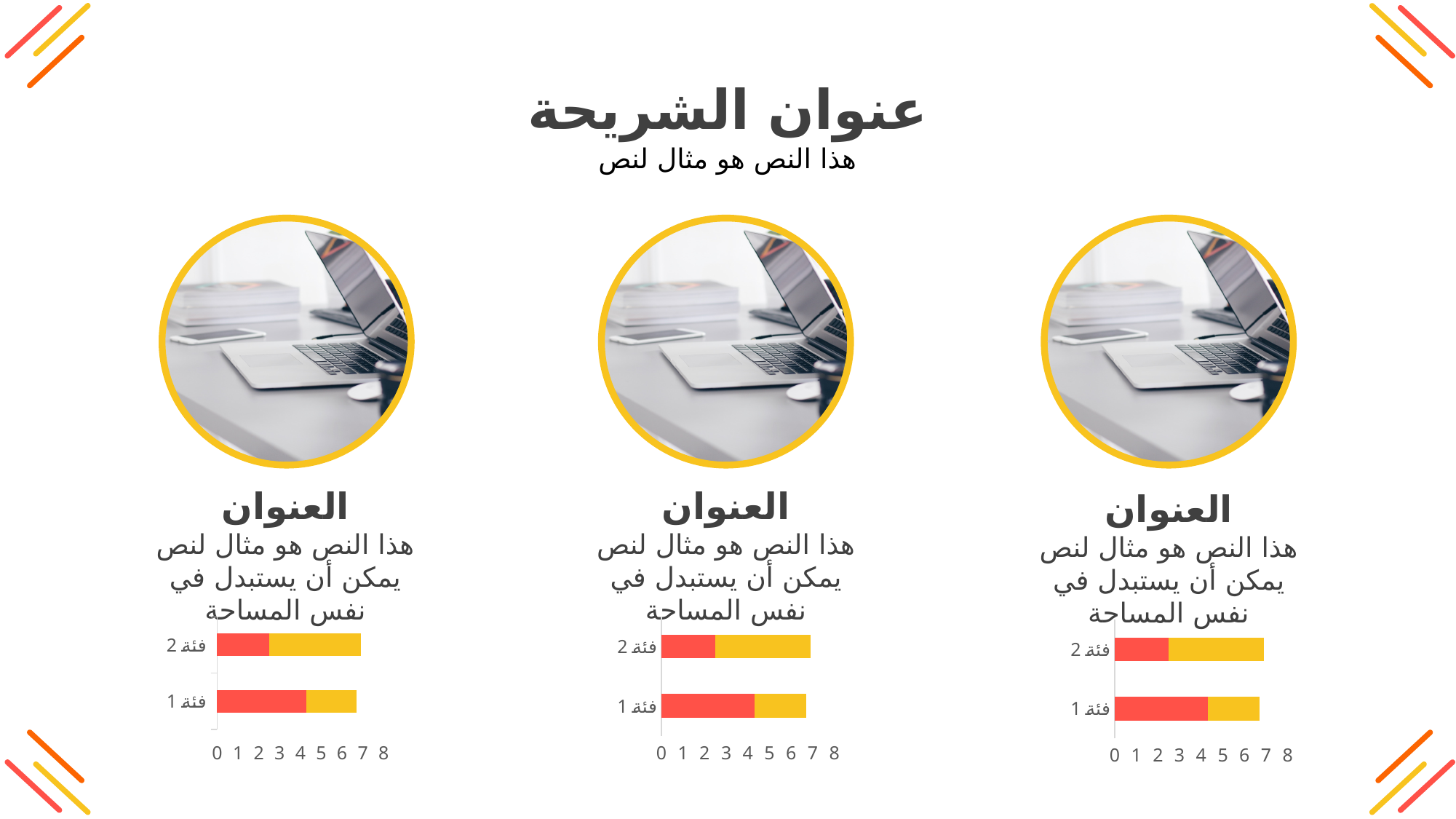
How many coloured segments make up each bar in the right-hand chart? 2 What kind of chart is shown under the left-hand column? Stacked bar chart In the right-hand chart, is the red segment of the bar for فئة 2 greater or less than 4? less How many categories does the right-hand chart show? 2 In the left-hand chart, is the total length of the bar for فئة 1 greater or less than 5? greater What are the category labels on the vertical axis of the middle chart? فئة 1 and فئة 2 In the middle chart, is the total length of the bar for فئة 2 greater or less than 5? greater How many categories does the left-hand chart show? 2 In the middle chart, what is the highest value shown on the horizontal axis? 8 In the middle chart, which category has the longer yellow segment, فئة 1 or فئة 2? فئة 2 In the left-hand chart, which category has the longer red segment, فئة 1 or فئة 2? فئة 1